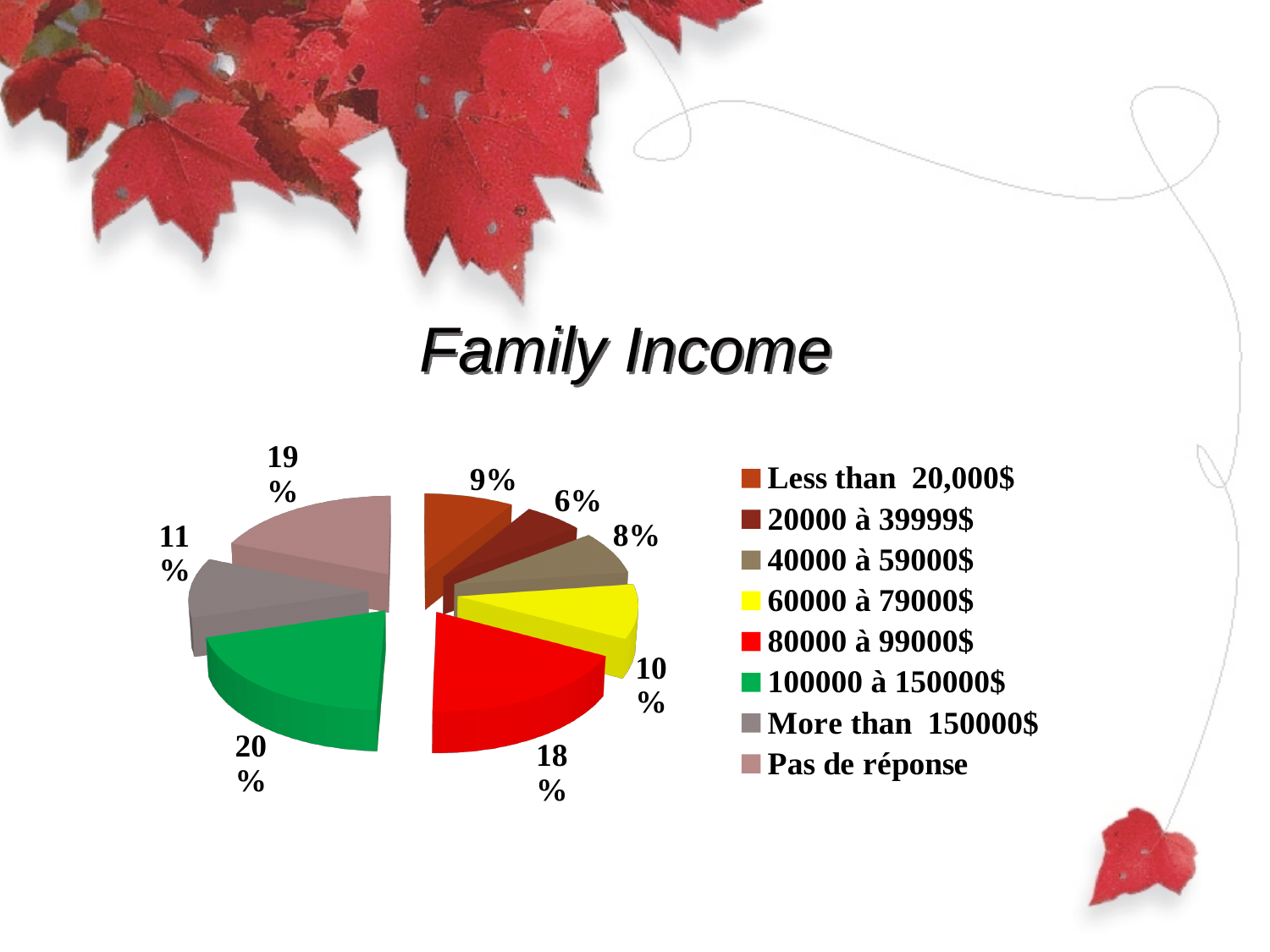
What percentage of the pie is the '100000 à 150000$' slice? 20% Which category has the smallest share of the pie? 20000 à 39999$ What is the difference in percentage points between '100000 à 150000$' and 'More than 150000$'? 9 What kind of chart is shown on the slide? Pie chart What percentage is shown for 'Less than 20,000$'? 9% How many categories does the pie chart have? 8 What colour is the slice for '60000 à 79000$'? Yellow Which category has the largest share of the pie? 100000 à 150000$ What percentage is shown for 'Pas de réponse'? 19% What percentage is shown for '80000 à 99000$'? 18% Which is larger, the share for '60000 à 79000$' or the share for '40000 à 59000$'? 60000 à 79000$ What is the title of the chart? Family Income